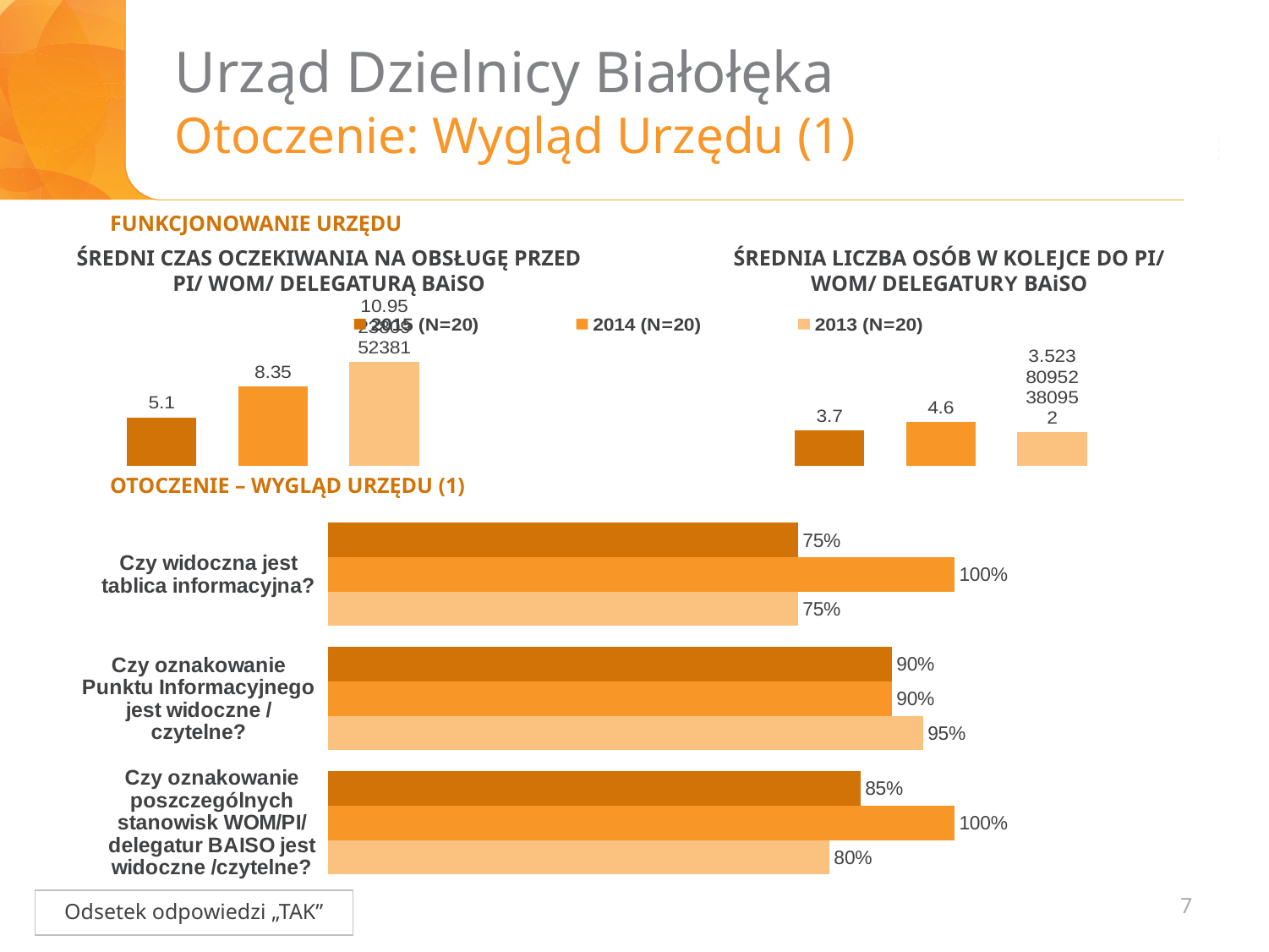
In the bottom chart 'OTOCZENIE – WYGLĄD URZĘDU (1)', how many questions (categories) are shown? 3 What type of chart is the bottom chart 'OTOCZENIE – WYGLĄD URZĘDU (1)'? Bar chart In the bottom chart 'OTOCZENIE – WYGLĄD URZĘDU (1)', what is the difference between the 2014 and 2013 values for 'Czy oznakowanie poszczególnych stanowisk WOM/PI/ delegatur BAISO jest widoczne /czytelne?'? 20% In the chart 'ŚREDNI CZAS OCZEKIWANIA NA OBSŁUGĘ PRZED PI/ WOM/ DELEGATURĄ BAiSO', which year has the lowest value? 2015 In the chart 'ŚREDNIA LICZBA OSÓB W KOLEJCE DO PI/ WOM/ DELEGATURY BAiSO', what is the value for 2014? 4.6 In the chart 'ŚREDNIA LICZBA OSÓB W KOLEJCE DO PI/ WOM/ DELEGATURY BAiSO', what is the value for 2015? 3.7 In the chart 'ŚREDNI CZAS OCZEKIWANIA NA OBSŁUGĘ PRZED PI/ WOM/ DELEGATURĄ BAiSO', what is the value for 2015? 5.1 How many series does the legend list for the charts on this slide? 3 In the chart 'ŚREDNI CZAS OCZEKIWANIA NA OBSŁUGĘ PRZED PI/ WOM/ DELEGATURĄ BAiSO', what is the value for 2014? 8.35 In the chart 'ŚREDNIA LICZBA OSÓB W KOLEJCE DO PI/ WOM/ DELEGATURY BAiSO', which year has the highest value? 2014 In the bottom chart 'OTOCZENIE – WYGLĄD URZĘDU (1)', what is the 2013 value for 'Czy oznakowanie Punktu Informacyjnego jest widoczne / czytelne?'? 95% In the bottom chart 'OTOCZENIE – WYGLĄD URZĘDU (1)', what is the 2014 value for 'Czy widoczna jest tablica informacyjna?'? 100%